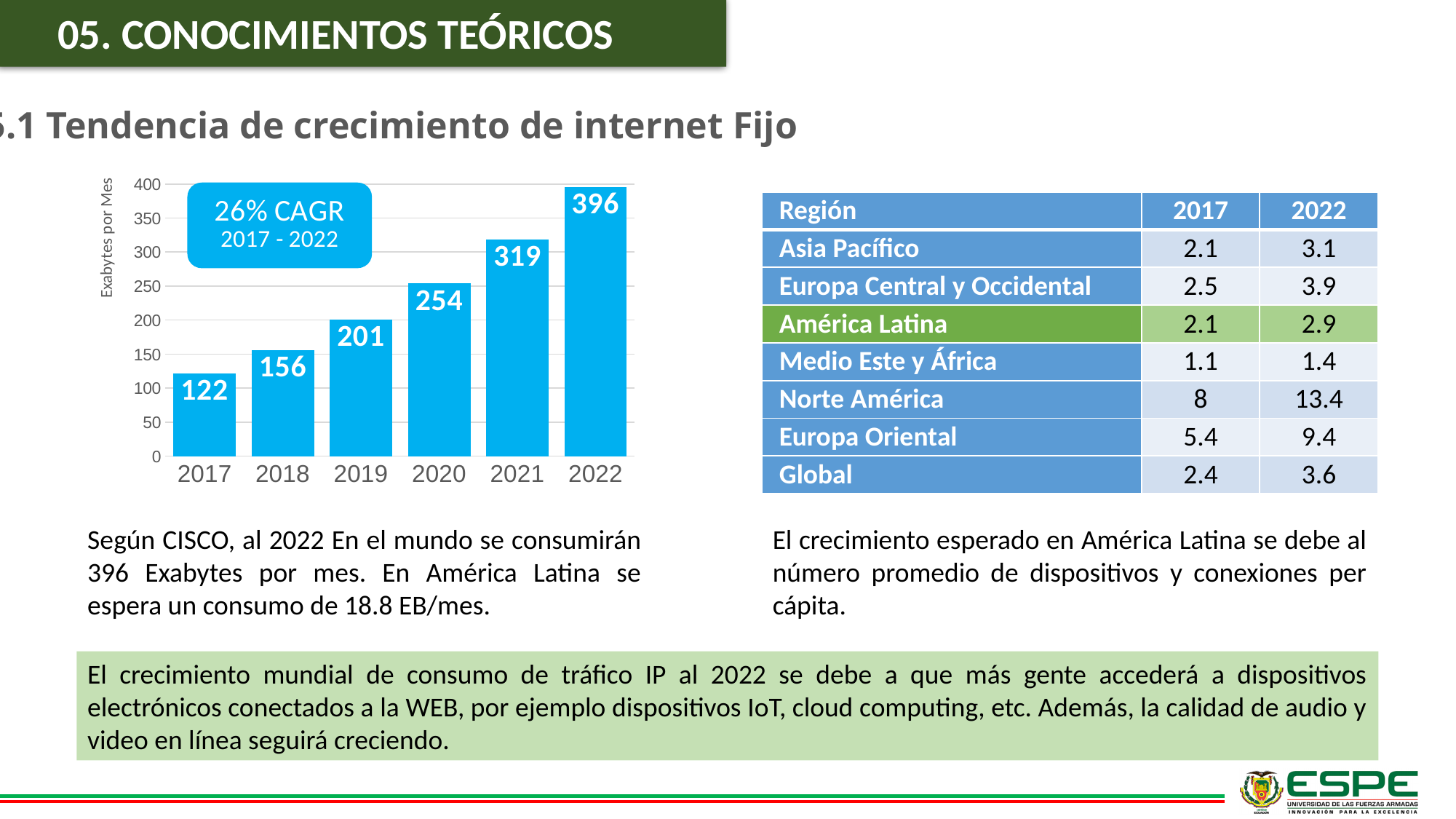
What kind of chart is shown on the slide? bar chart Do the values in the bar chart rise or fall from 2017 to 2022? rise Which year has the highest value in the bar chart? 2022 What is the difference between the values for 2019 and 2018 in the bar chart? 45 What is the value for 2017 in the bar chart? 122 How many years are shown on the x axis of the bar chart? 6 What is the value for 2022 in the bar chart? 396 What is the value for 2020 in the bar chart? 254 What is the difference between the values for 2022 and 2017 in the bar chart? 274 Which year has the lowest value in the bar chart? 2017 Which is larger in the bar chart, the value for 2021 or the value for 2020? 2021 Is the value for 2019 in the bar chart greater or less than 150? greater